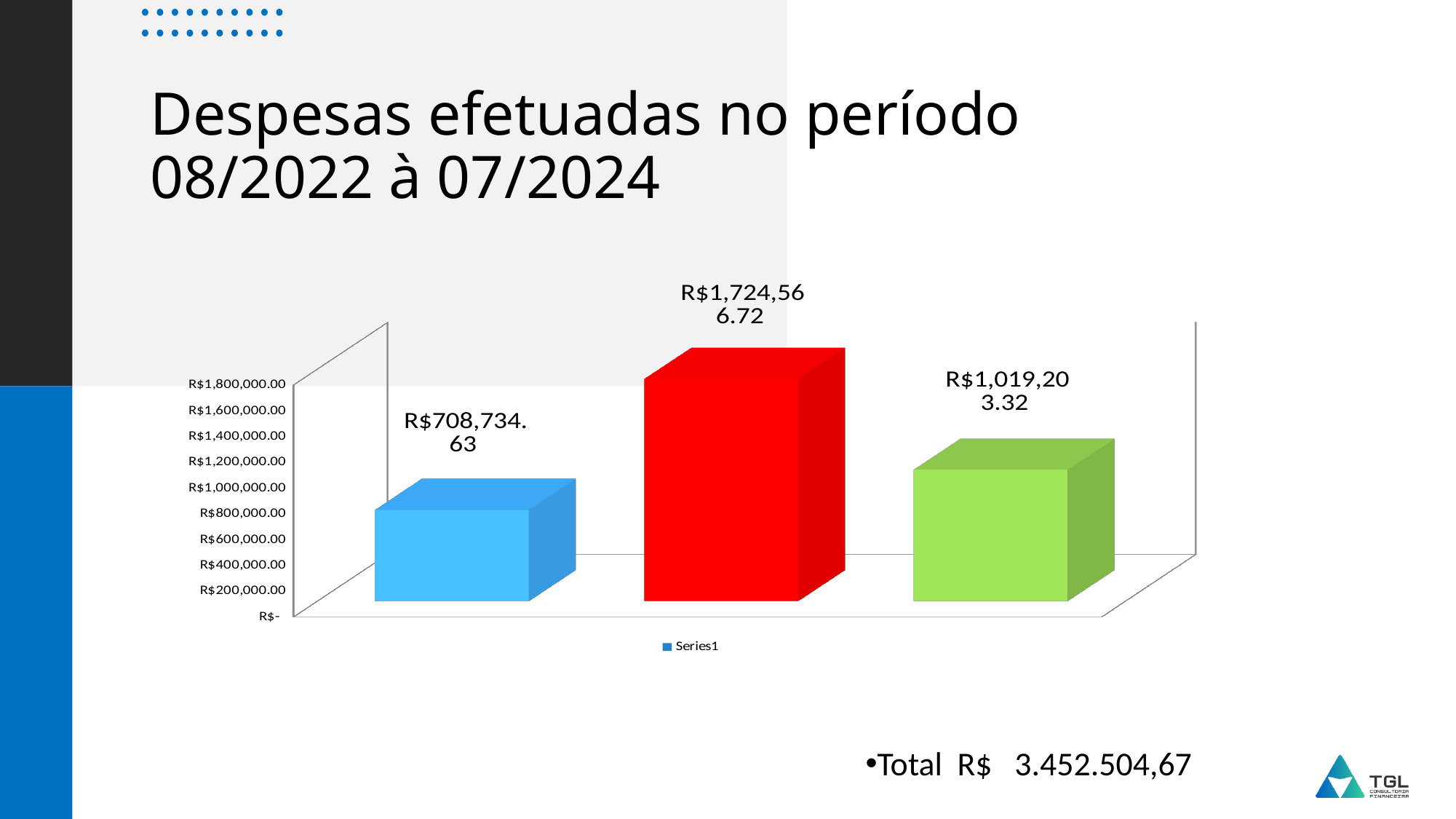
What is the value shown on the green (rightmost) bar? R$1,019,203.32 Is the value of the red bar greater or less than R$1,600,000.00? greater What is the value shown on the red (middle) bar? R$1,724,566.72 How many series does the legend list? 1 What is the difference between the red bar's value and the blue bar's value? R$1,015,832.09 What is the value shown on the blue (leftmost) bar? R$708,734.63 Which bar has the lowest value? The blue (leftmost) bar How many bars are plotted in the chart? 3 What is the difference between the green bar's value and the blue bar's value? R$310,468.69 Which bar has the highest value? The red (middle) bar What kind of chart is shown on the slide? Bar chart Which is larger, the value of the green bar or the value of the blue bar? The green bar